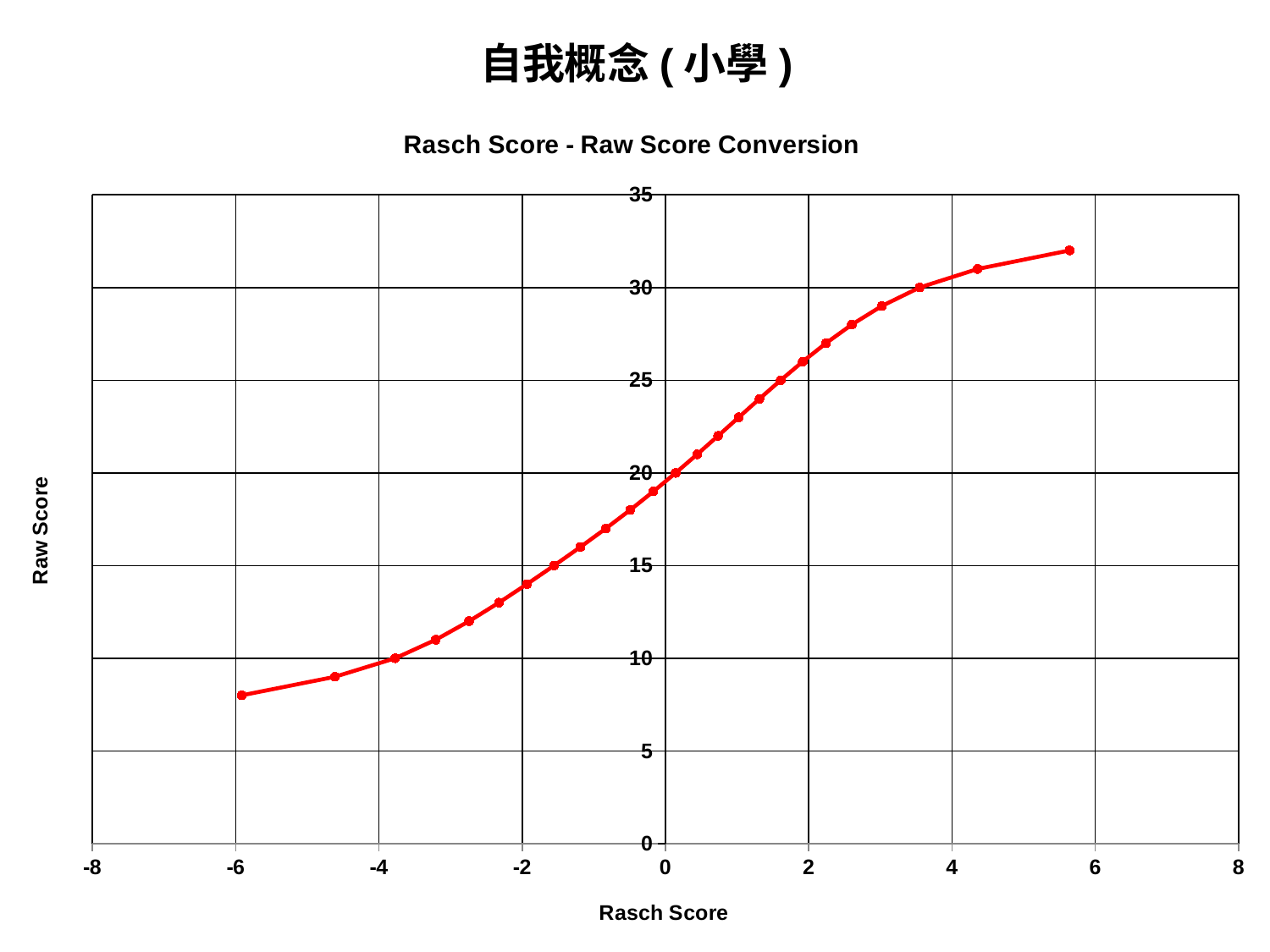
Which point has the higher raw score: the one at a Rasch score of about -2 or the one at about 4? the one at about 4 How many data points are plotted on the line? 25 What kind of chart is shown on the slide? line chart What is the label of the vertical axis? Raw Score What is the title of the chart? Rasch Score - Raw Score Conversion Is the raw score at a Rasch score of about 2 greater or less than 25? greater What is the highest value shown on the vertical axis? 35 Does the raw score rise or fall as the Rasch score increases along the x axis? rise Is the raw score at a Rasch score of about -4 greater or less than 15? less Is the raw score of the leftmost point (lowest Rasch score) greater or less than 10? less